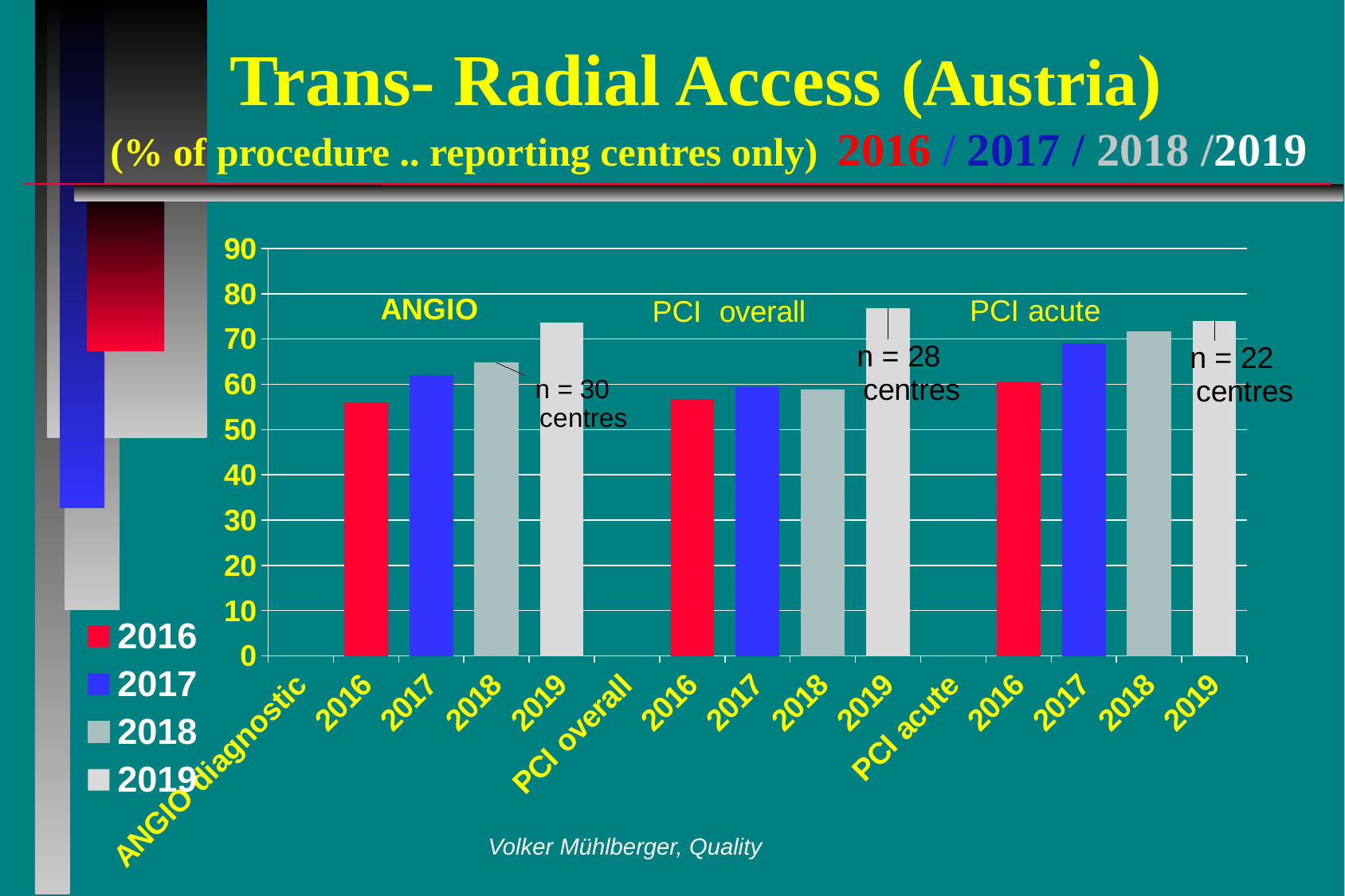
How many series does the legend list? 4 How many bars are plotted in the chart? 12 Is the value for ANGIO diagnostic 2016 greater or less than 60? less Within the ANGIO diagnostic group, do the values rise or fall from 2016 to 2019? rise Which bar is the highest in the chart? PCI overall 2019 How many procedure groups (ANGIO diagnostic, PCI overall, PCI acute) are shown on the x axis? 3 What kind of chart is shown on the slide? bar chart How many centres are reported for PCI acute according to the annotation on the chart? n = 22 centres What colour represents the 2016 series in the legend? red Is the value for ANGIO diagnostic 2019 greater or less than 70? greater Which is larger, the PCI acute 2018 bar or the PCI overall 2018 bar? PCI acute 2018 Is the value for PCI acute 2016 greater or less than 70? less